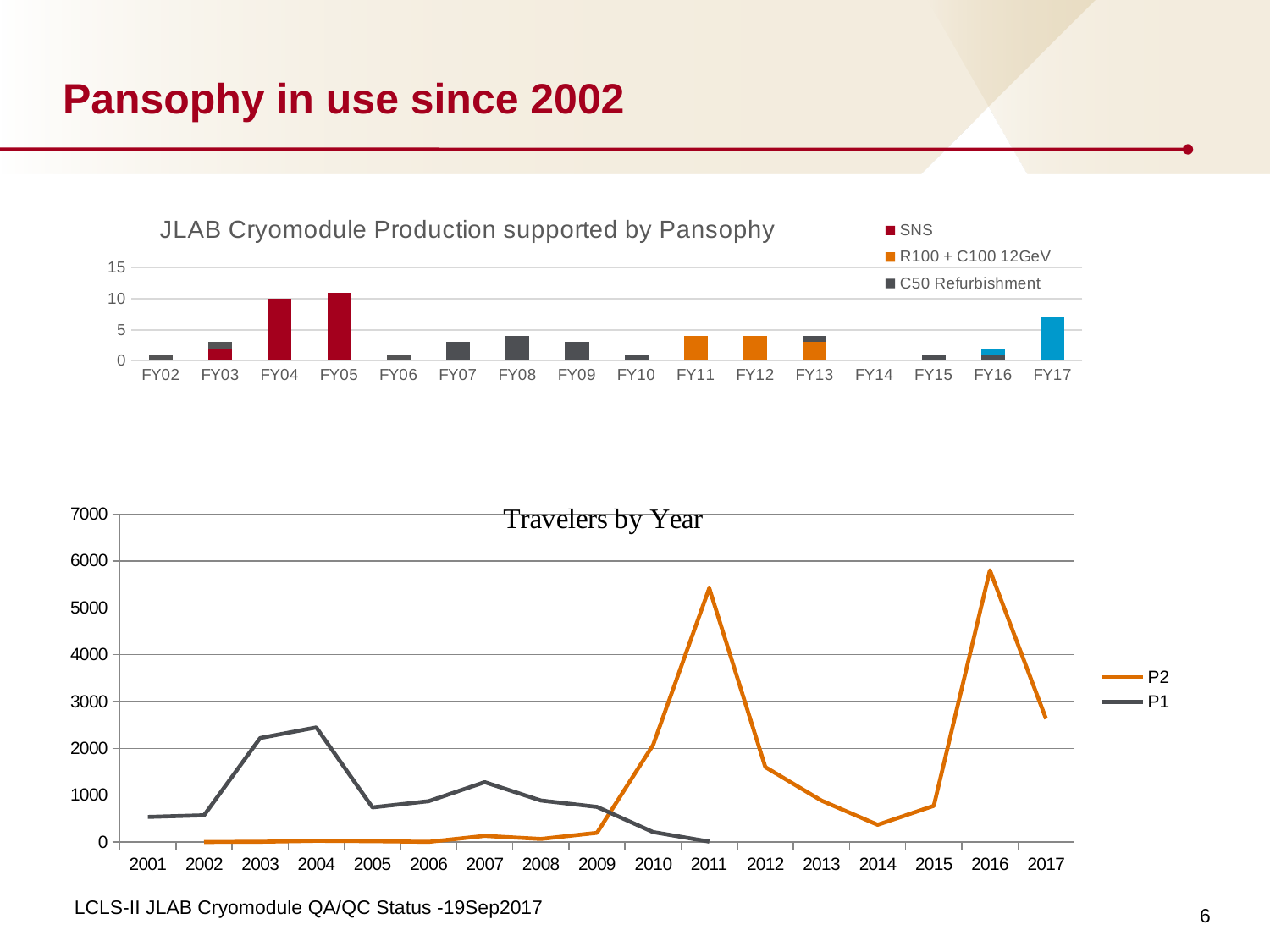
What kind of chart is the top chart, 'JLAB Cryomodule Production supported by Pansophy'? Bar chart In the top chart, how many fiscal-year categories are shown on the x axis? 16 In the bottom chart, is the P2 value for 2011 greater or less than 5000? greater In the bottom chart, how many years are shown on the x axis? 17 In the top chart, which legend entry is shown in dark red? SNS In the top chart, how many series does the legend list? 3 What kind of chart is the bottom chart, 'Travelers by Year'? Line chart In the bottom chart, in which year does the P2 series reach its highest value? 2016 In the bottom chart, is the P1 value for 2004 greater or less than 2000? greater In the bottom chart, how many series does the legend list? 2 In the top chart, is the total value for FY05 greater or less than 5? greater